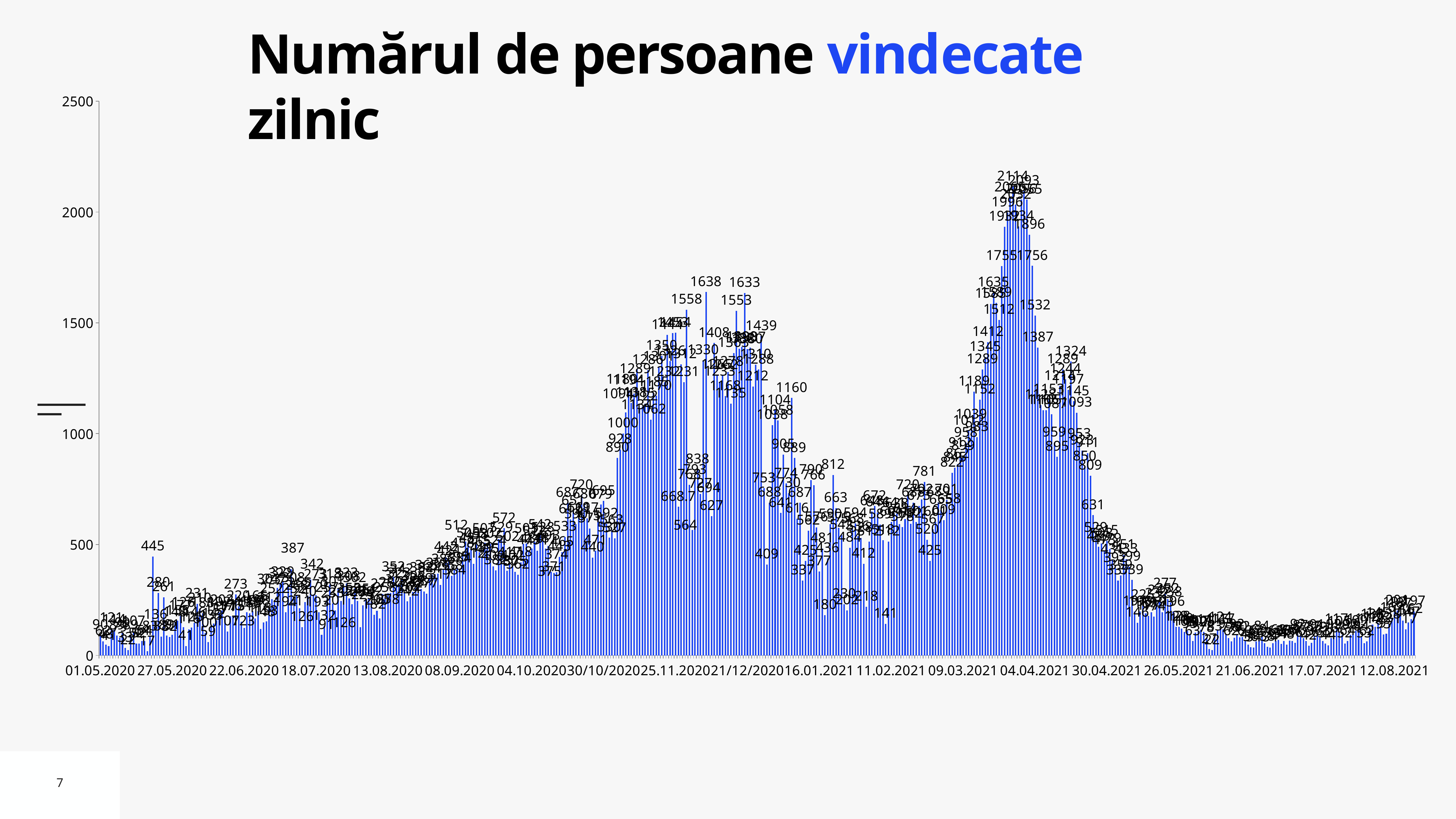
Which peak is higher: the one around 04.04.2021 or the one around 25.11.2020? the one around 04.04.2021 Is the highest peak of the chart, around 04.04.2021, greater or less than 2000? greater What is the maximum value shown on the y axis? 2500 What is the title of the chart on the slide? Numărul de persoane vindecate zilnic Is the peak of the chart around 25.11.2020 greater or less than 1500? greater Which labelled peak is larger: the 445 near 27.05.2020 or the 387 near 18.07.2020? 445 Are the values around 12.08.2021 greater or less than 500? less What is the highest data label shown on the chart? 2114 How many date labels are shown on the x axis? 19 Do the values rise or fall between 04.04.2021 and 26.05.2021? fall What kind of chart is shown on the slide? bar chart